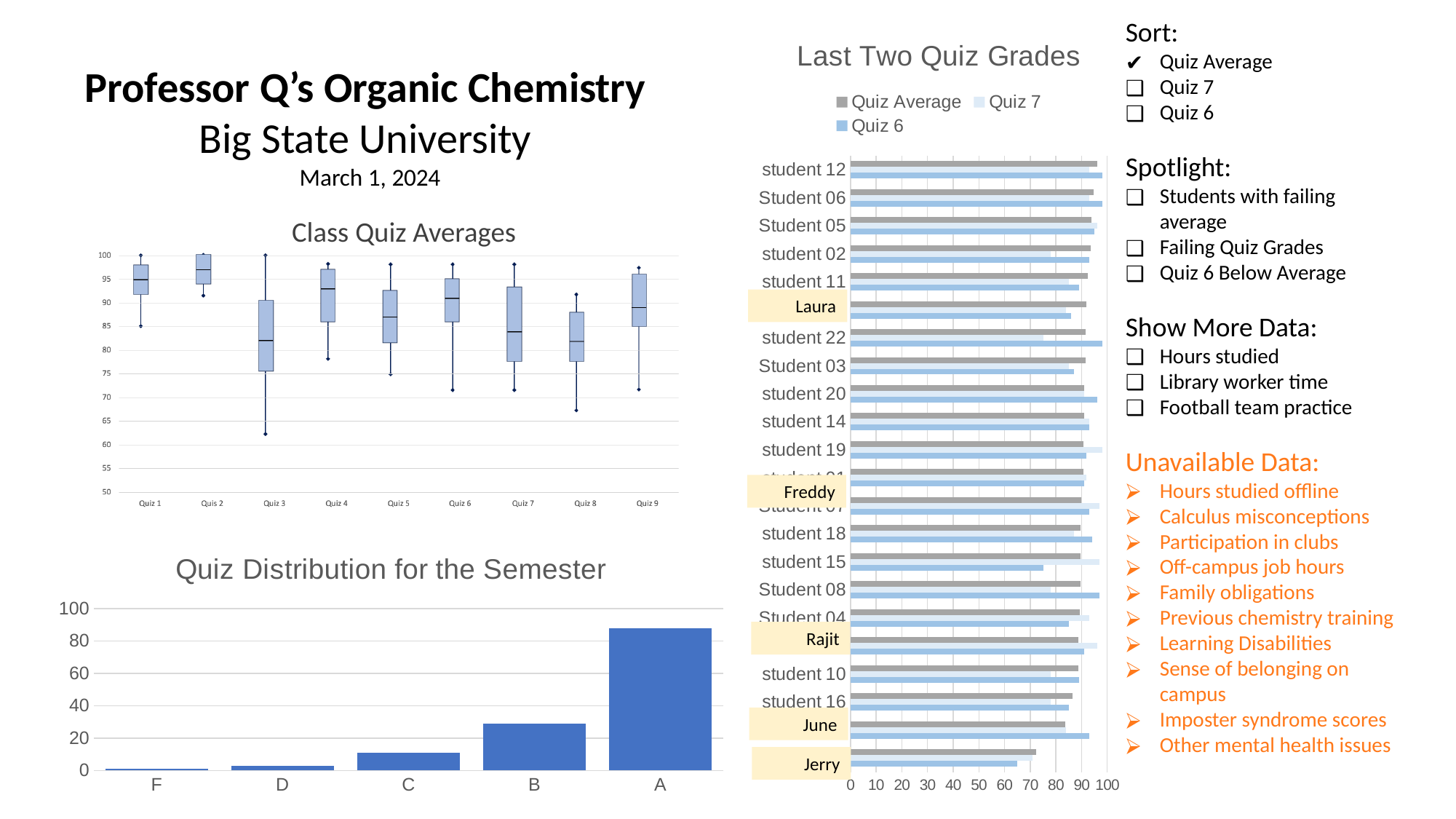
What kind of chart is "Quiz Distribution for the Semester"? bar chart How many series does the legend of the "Last Two Quiz Grades" chart list? 3 How many quizzes are shown on the x axis of the "Class Quiz Averages" chart? 9 In the "Quiz Distribution for the Semester" chart, do the values rise or fall moving from F to A along the x axis? rise In the "Quiz Distribution for the Semester" chart, is the value for B greater or less than 40? less How many grade categories are shown in the "Quiz Distribution for the Semester" chart? 5 In the "Quiz Distribution for the Semester" chart, which grade category has the highest value? A In the "Quiz Distribution for the Semester" chart, which grade category has the lowest value? F In the "Quiz Distribution for the Semester" chart, is the value for A greater or less than 80? greater In the "Quiz Distribution for the Semester" chart, which is larger, the value for C or the value for B? B In the "Last Two Quiz Grades" chart, is Jerry's Quiz Average greater or less than 80? less In the "Last Two Quiz Grades" chart, which student has the lowest Quiz Average? Jerry